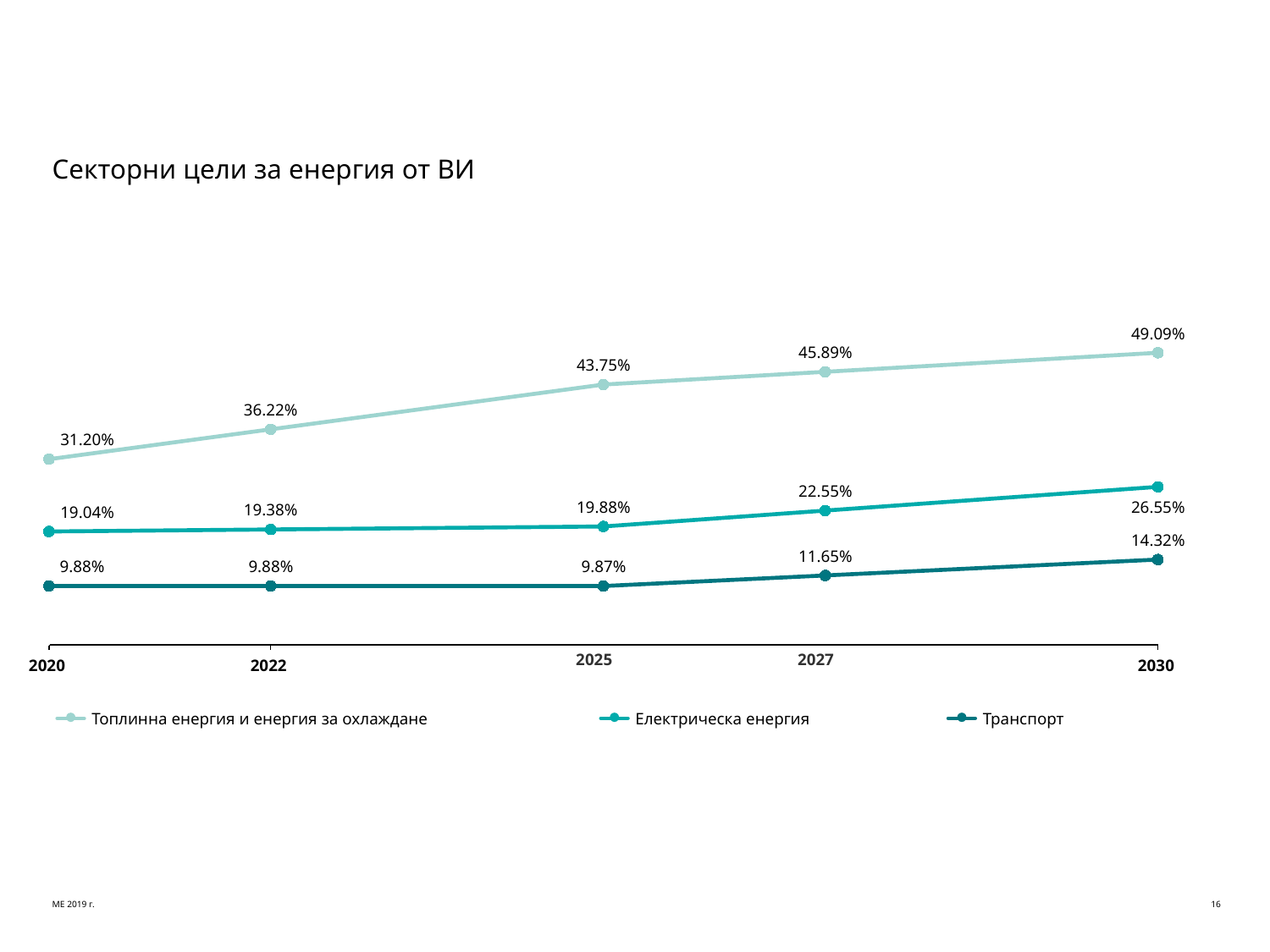
What is the value for Топлинна енергия и енергия за охлаждане in 2030? 49.09% Which is larger in 2025: the value for Електрическа енергия or the value for Транспорт? Електрическа енергия In which year is the value for Топлинна енергия и енергия за охлаждане highest? 2030 What is the value for Електрическа енергия in 2020? 19.04% How many series does the legend list? 3 In which year is the value for Електрическа енергия lowest? 2020 Does the value for Топлинна енергия и енергия за охлаждане rise or fall from 2020 to 2030? Rise What kind of chart is shown on the slide? Line chart What is the difference between the Транспорт values in 2030 and 2027? 2.67% What is the value for Електрическа енергия in 2027? 22.55% How many years are shown on the x axis? 5 What is the value for Транспорт in 2025? 9.87%